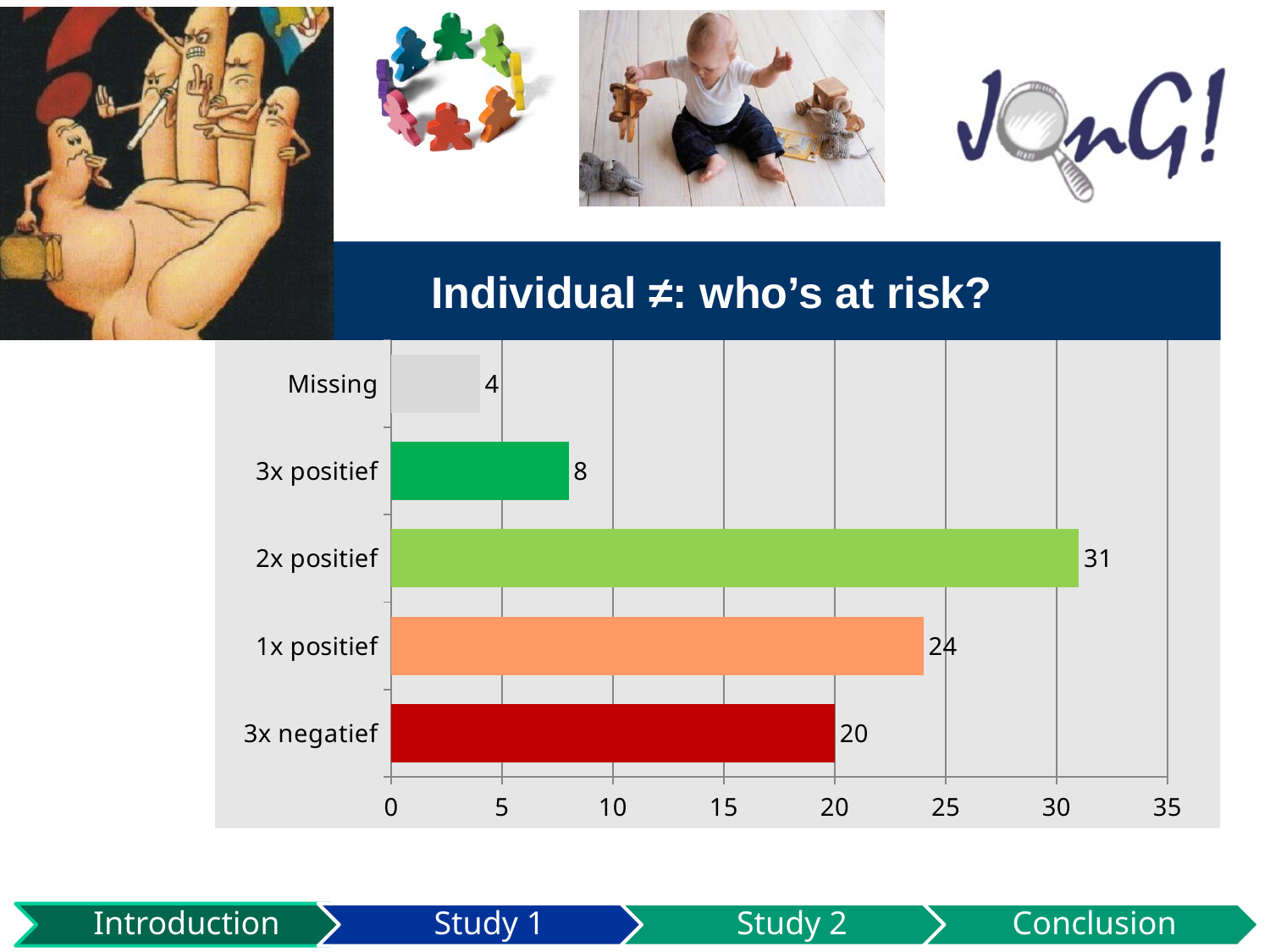
What is the title shown above the chart? Individual ≠: who's at risk? Which category has the lowest value? Missing Which is larger, the value for 1x positief or the value for 3x negatief? 1x positief What is the value for 3x negatief? 20 Is the value for 3x positief greater or less than 10? less What kind of chart is shown on the slide? bar chart What is the total of the values for 3x positief and 3x negatief? 28 How many categories are shown in the chart? 5 What is the value for Missing? 4 What is the value for 2x positief? 31 What is the difference between the values for 2x positief and 1x positief? 7 Which category has the highest value? 2x positief